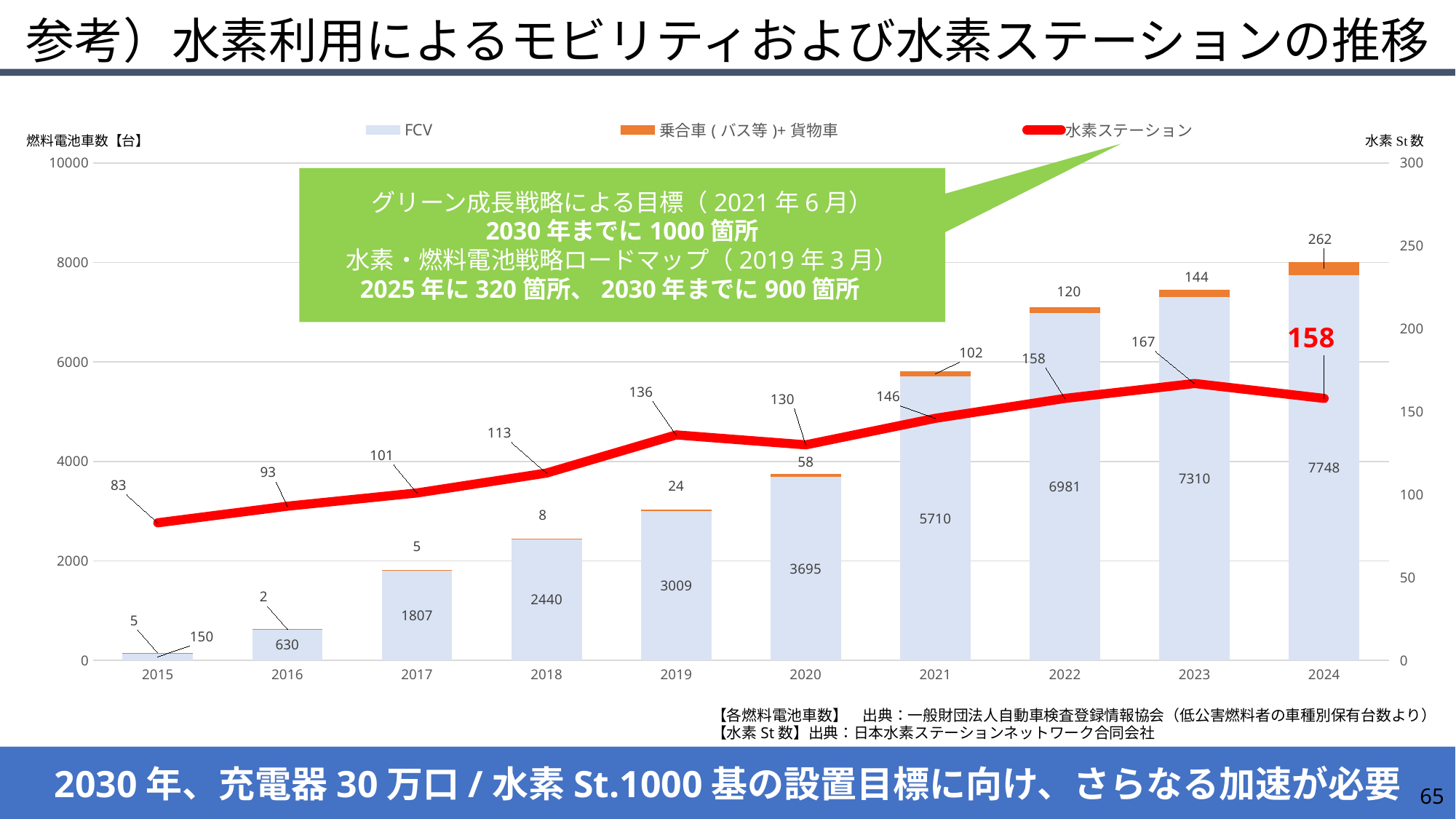
Which year has the highest FCV value? 2024 Is the FCV value for 2021 greater or less than 4000? greater How many years are shown on the x axis? 10 Which is larger, the 水素ステーション value for 2019 or for 2020? 2019 What is the 乗合車(バス等)+貨物車 value for 2024? 262 What colour is the 水素ステーション line? Red Which year has the lowest 水素ステーション value? 2015 What is the total of the stacked bar for 2020 (FCV plus 乗合車(バス等)+貨物車)? 3753 How many series does the legend list? 3 What is the difference between the FCV values for 2024 and 2023? 438 What is the FCV value for 2022? 6981 What is the 水素ステーション value for 2019? 136